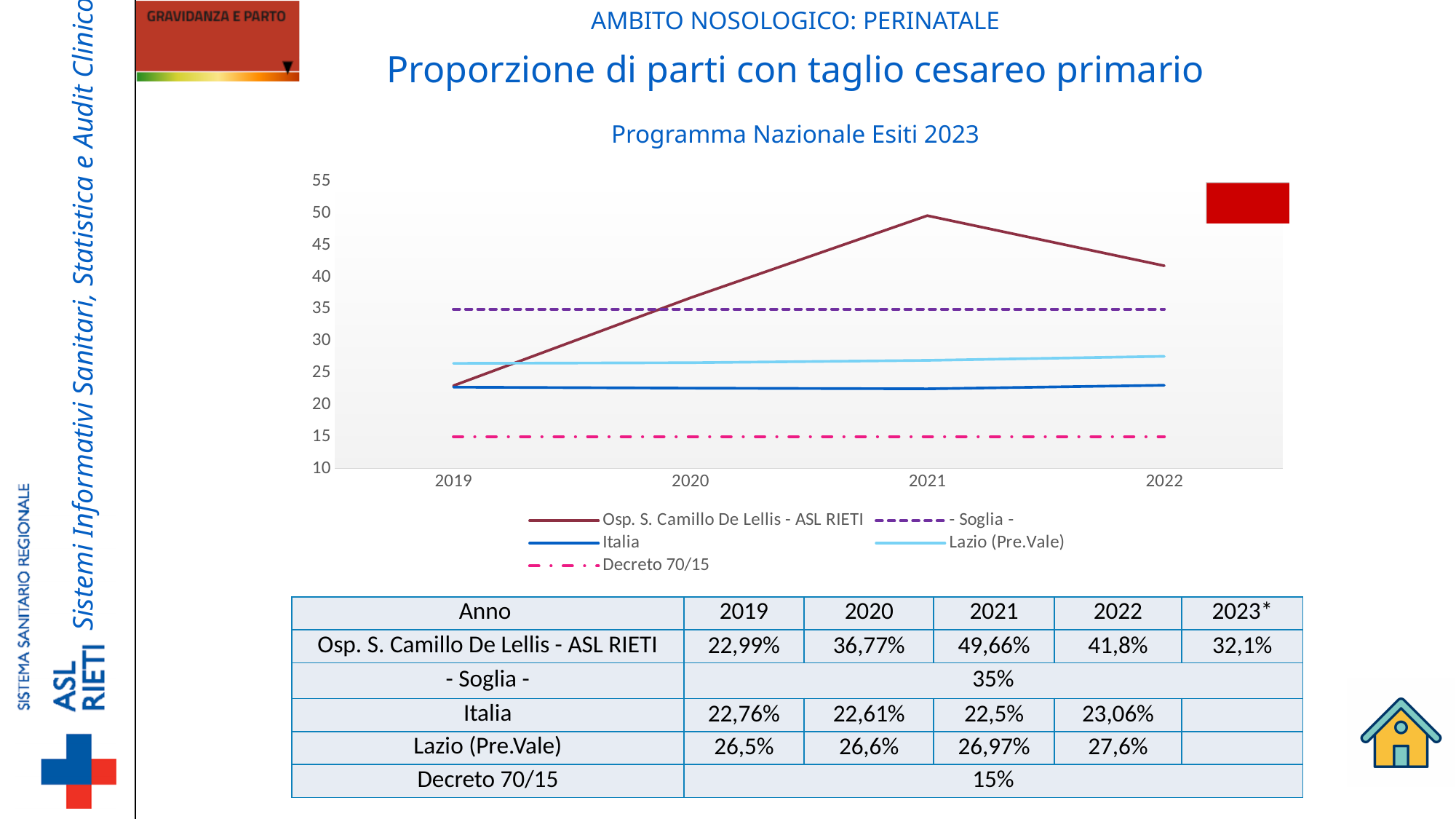
In which year is the Osp. S. Camillo De Lellis - ASL RIETI value lowest? 2019 Is the value for Osp. S. Camillo De Lellis - ASL RIETI in 2019 greater or less than 25? less How many years are plotted along the x axis of the chart? 4 What is the value for Osp. S. Camillo De Lellis - ASL RIETI in 2021? 49,66% What is the difference between the Osp. S. Camillo De Lellis - ASL RIETI values for 2021 and 2022? 7,86 What kind of chart is shown on the slide? line chart In 2022, which is larger: the value for Osp. S. Camillo De Lellis - ASL RIETI or the value for Lazio (Pre.Vale)? Osp. S. Camillo De Lellis - ASL RIETI What is the title shown directly above the chart? Programma Nazionale Esiti 2023 Does the Lazio (Pre.Vale) line rise or fall from 2019 to 2022? rises What constant value does the - Soglia - line represent? 35% How many series does the chart legend list? 5 In which year does the Osp. S. Camillo De Lellis - ASL RIETI line reach its highest value? 2021